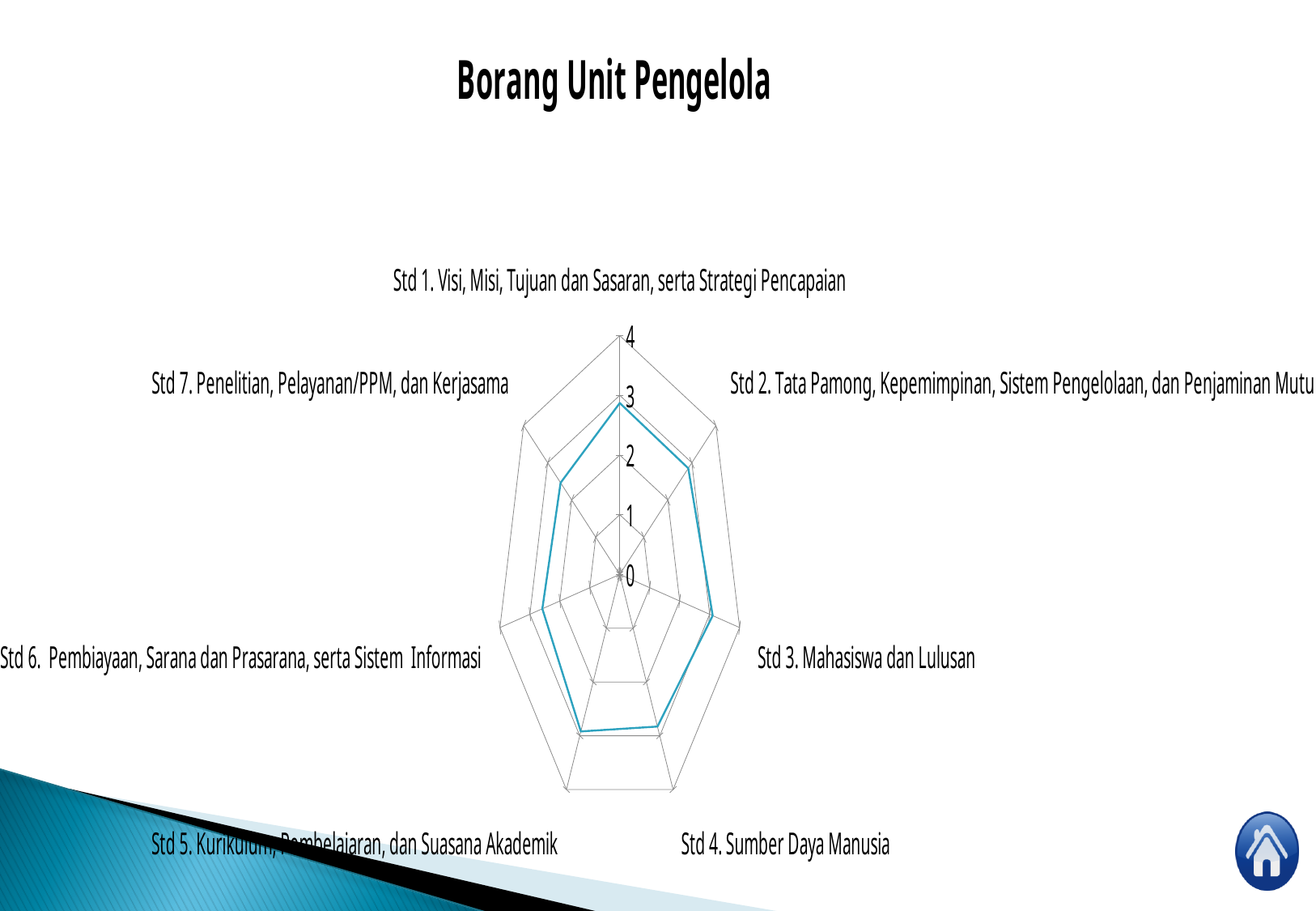
Is the value for Std 2. Tata Pamong, Kepemimpinan, Sistem Pengelolaan, dan Penjaminan Mutu greater or less than 2? greater Is the value for Std 5. Kurikulum, Pembelajaran, dan Suasana Akademik greater or less than 4? less What is the title of the chart? Borang Unit Pengelola Is the value for Std 4. Sumber Daya Manusia greater or less than 2? greater What is the maximum value shown on the chart's axis scale? 4 What kind of chart is shown on the slide? radar chart How many categories (axes) does the radar chart have? 7